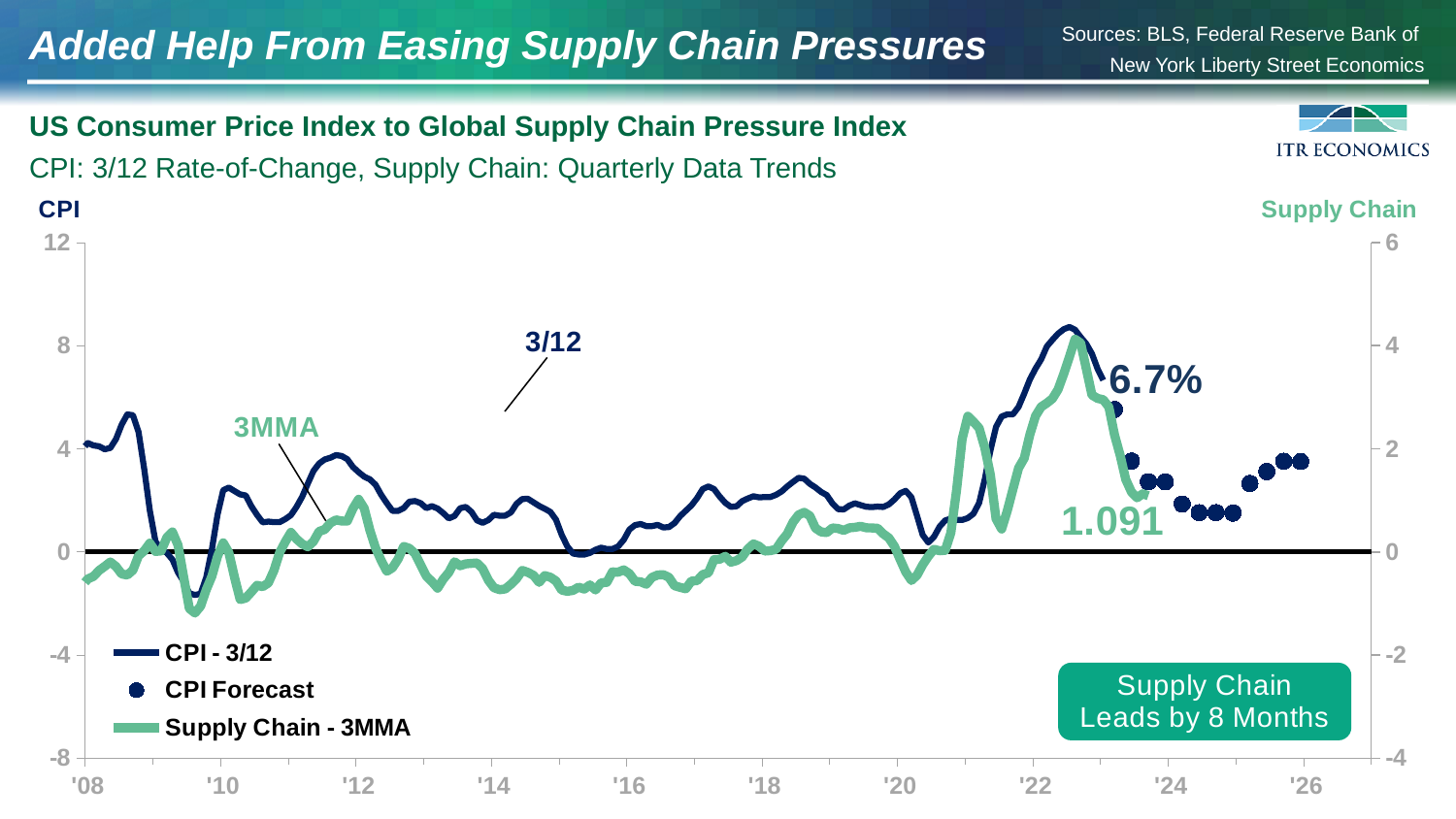
How many year labels are shown on the x axis? 10 Does the CPI - 3/12 series rise or fall from its 2022 peak to 2023? fall What is the latest labeled value of the CPI - 3/12 series? 6.7% What kind of chart is shown on the slide? line chart What is the title of the chart? US Consumer Price Index to Global Supply Chain Pressure Index What does the callout box in the lower right of the chart say? Supply Chain Leads by 8 Months Is the value of the CPI - 3/12 series around 2015 greater or less than 4 on the left axis? less How many series does the legend list? 3 Is the peak value of the CPI - 3/12 series around 2022 greater or less than 8 on the left axis? greater What is the latest labeled value of the Supply Chain - 3MMA series? 1.091 Is the peak value of the Supply Chain - 3MMA series around 2022 greater or less than 2 on the right axis? greater